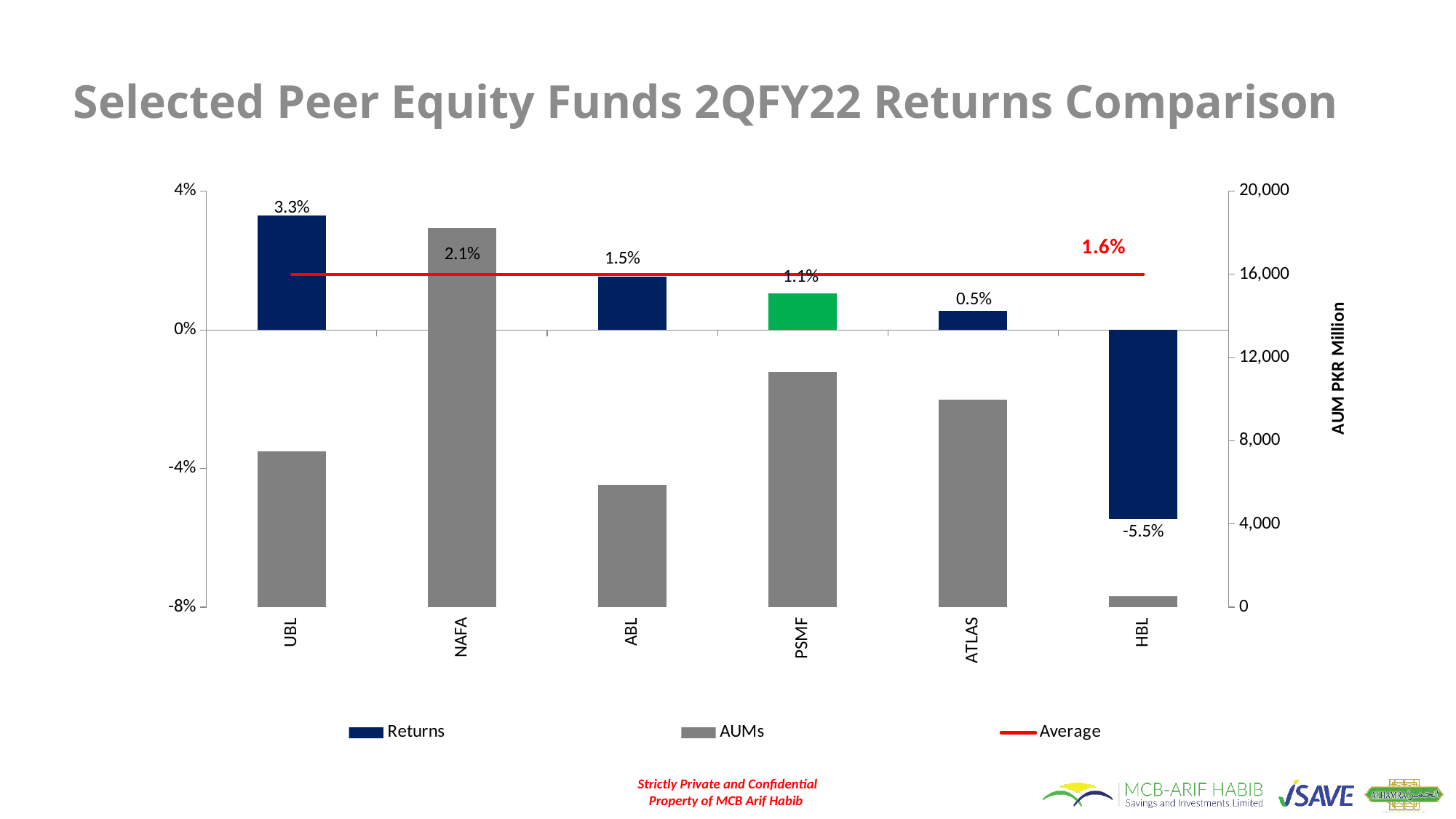
What is the return shown for HBL? -5.5% Which fund has the lowest return? HBL How many funds are shown on the x axis? 6 Which fund has the highest return? UBL What is the 2QFY22 return shown for UBL? 3.3% What is the return shown for ATLAS? 0.5% Is the AUM value for HBL greater or less than 4,000? less How many series does the legend list? 3 Which fund has the higher return, ABL or PSMF? ABL What value is labelled on the red Average line? 1.6% Is the AUM value for NAFA greater or less than 16,000? greater What is the difference between the returns of UBL and ABL? 1.8%